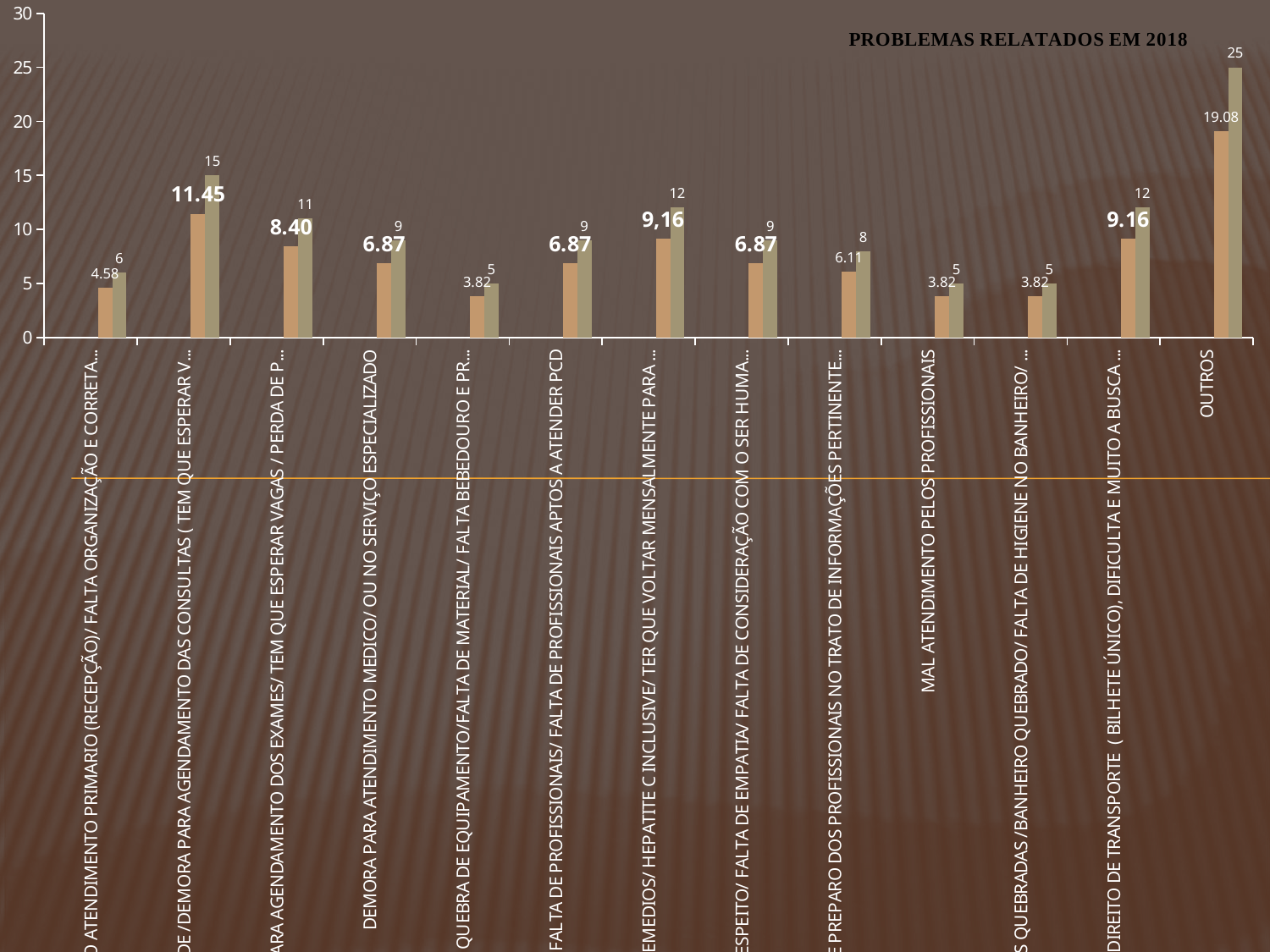
Which category has the highest bars in the chart? OUTROS What kind of chart is shown on the slide? bar chart Is the value of the right (olive) bar for OUTROS greater or less than 20? greater What is the difference between the right (olive) bar and the left (tan) bar for OUTROS? 5.92 What is the value of the left (tan) bar for MAL ATENDIMENTO PELOS PROFISSIONAIS? 3.82 What is the title of the chart? PROBLEMAS RELATADOS EM 2018 What is the value of the right (olive) bar for MAL ATENDIMENTO PELOS PROFISSIONAIS? 5 What is the value of the right (olive) bar for the category OUTROS? 25 How many categories are plotted along the x axis of the chart? 13 What is the value of the left (tan) bar for DEMORA PARA ATENDIMENTO MEDICO/ OU NO SERVIÇO ESPECIALIZADO? 6.87 Which has a larger right (olive) bar: OUTROS or MAL ATENDIMENTO PELOS PROFISSIONAIS? OUTROS What is the value of the left (tan) bar for the category OUTROS? 19.08